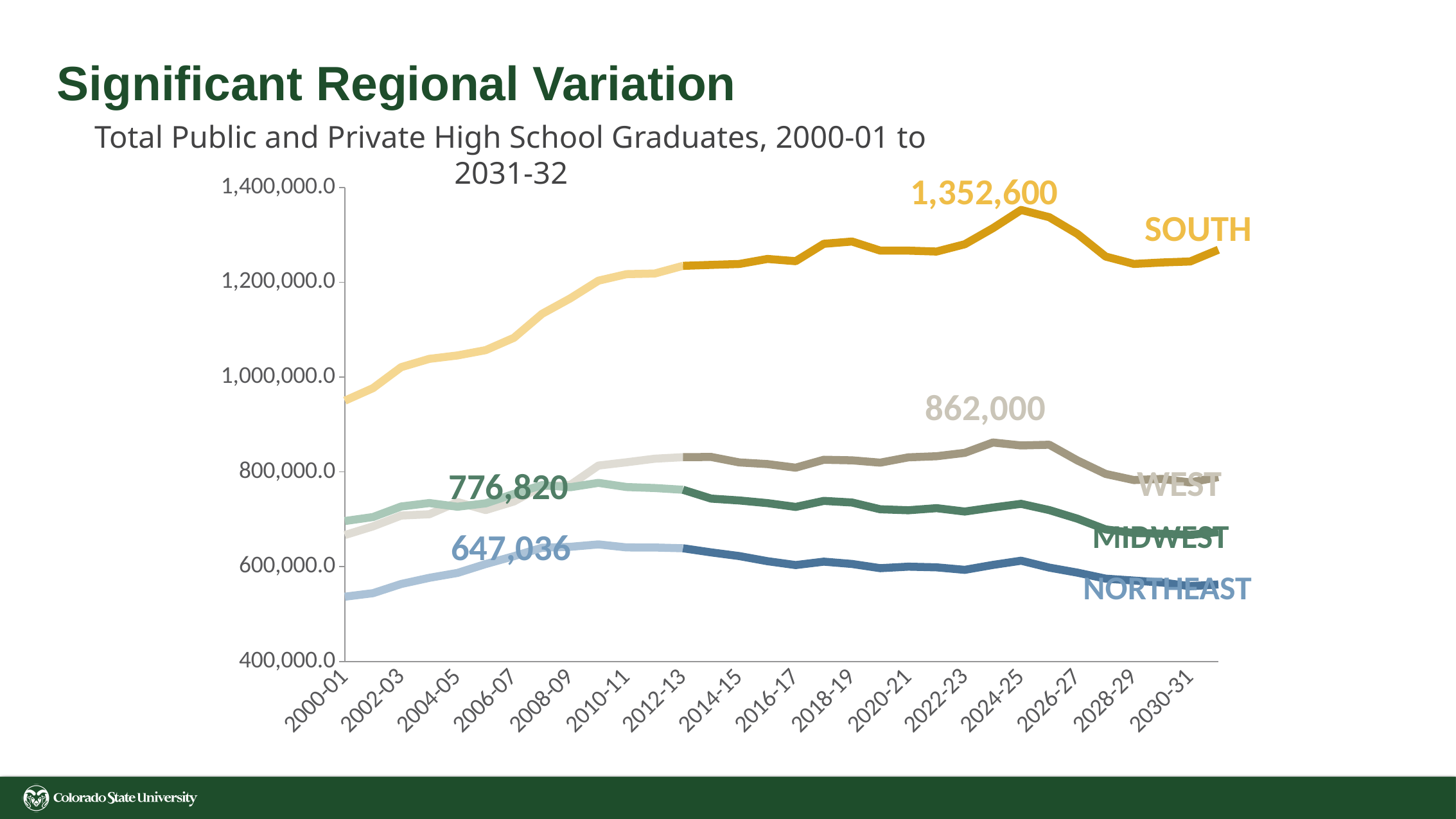
Is the value for SOUTH in 2000-01 greater or less than 1,000,000? less What is the peak value labelled on the WEST line? 862,000 Which region has the highest number of high school graduates across the whole period? SOUTH Does the SOUTH line rise or fall from 2000-01 to 2010-11? rises Which region has the lowest number of high school graduates across the whole period? NORTHEAST What is the peak value labelled on the SOUTH line? 1,352,600 What kind of chart is shown on the slide? line chart What is the peak value labelled on the NORTHEAST line? 647,036 What is the peak value labelled on the MIDWEST line? 776,820 What is the difference between the labelled peak values for SOUTH and WEST? 490,600 What is the title of the chart? Total Public and Private High School Graduates, 2000-01 to 2031-32 How many regional lines are plotted on the chart? 4